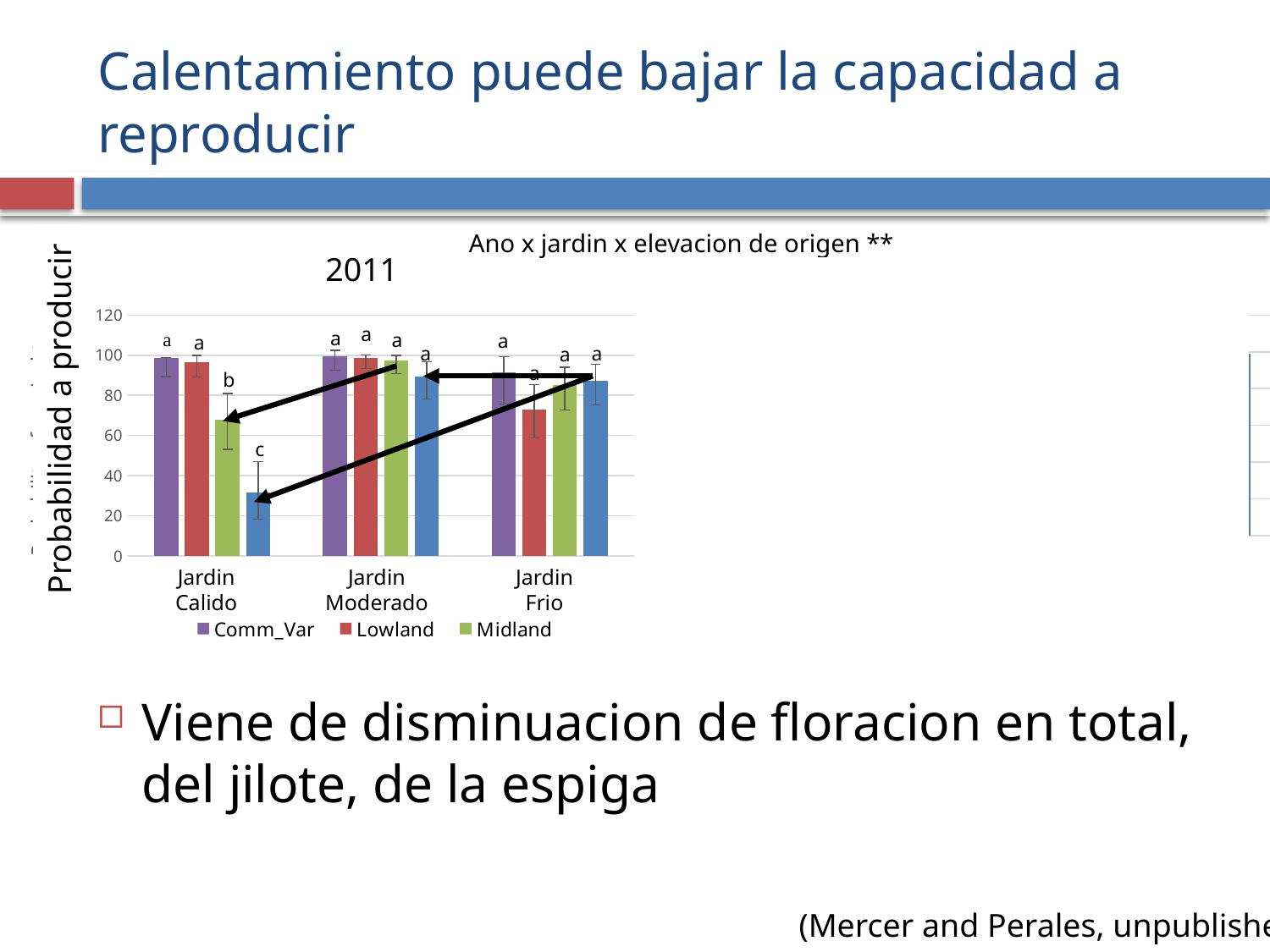
Which garden category contains the lowest bar in the chart? Jardin Calido How many garden categories are shown on the x axis of the chart? 3 Which is larger: the Lowland value for Jardin Moderado or the Lowland value for Jardin Frio? Jardin Moderado Is the value for Lowland in Jardin Frio greater or less than 60? greater Is the value for Comm_Var in Jardin Calido greater or less than 80? greater Is the value of the blue bar for Jardin Calido greater or less than 60? less What colour are the Lowland bars in the chart? red What is the title shown above the chart? 2011 How many bars are plotted for each garden category in the chart? 4 Which is larger: the Midland value for Jardin Calido or the Midland value for Jardin Moderado? Jardin Moderado What kind of chart is shown on the slide? bar chart